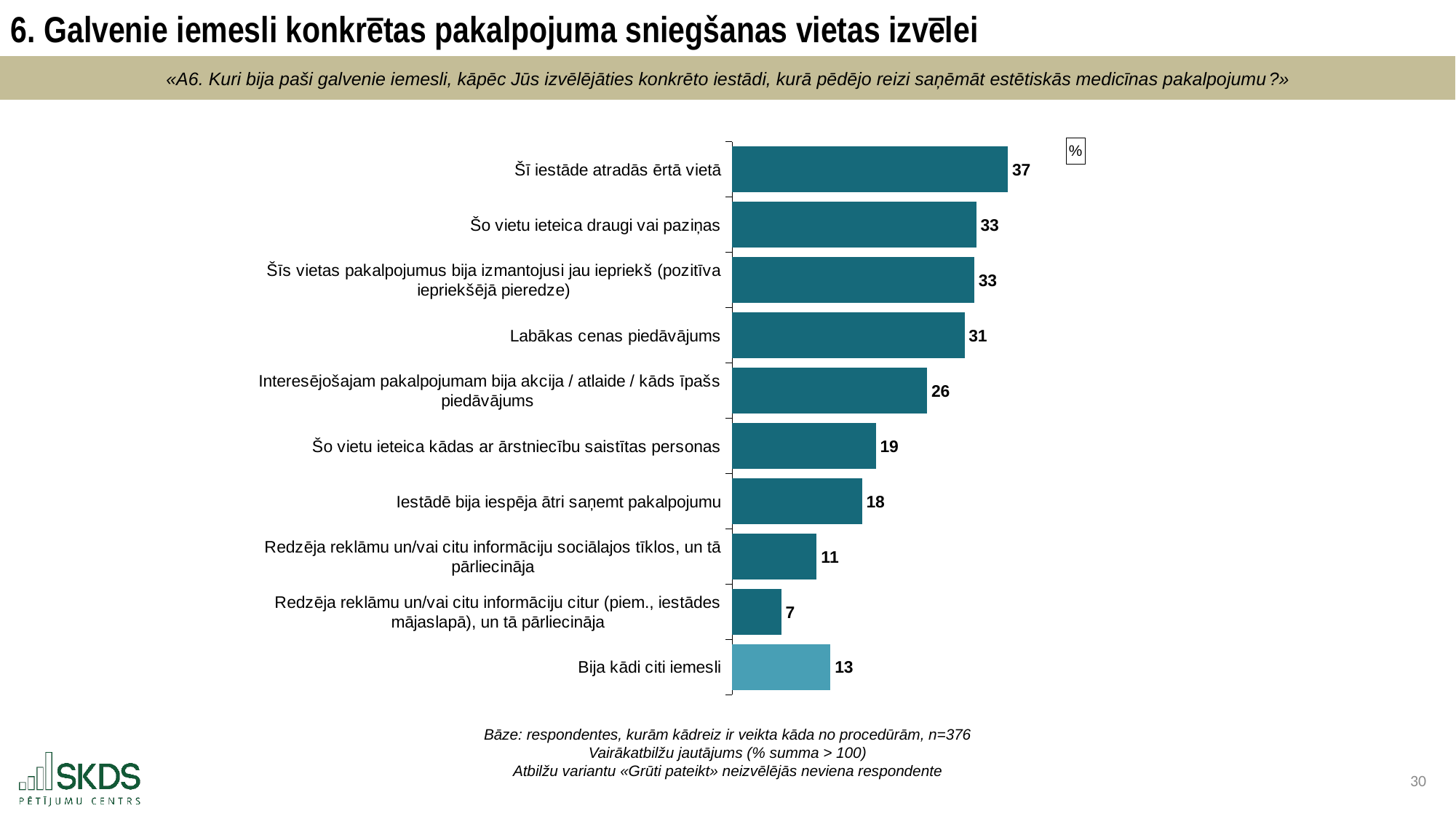
What is the value for "Labākas cenas piedāvājums"? 31 How many categories are shown in the chart? 10 What is the difference between the values for "Interesējošajam pakalpojumam bija akcija / atlaide / kāds īpašs piedāvājums" and "Šo vietu ieteica kādas ar ārstniecību saistītas personas"? 7 What kind of chart is shown on the slide? Bar chart What is the difference between the values for "Šī iestāde atradās ērtā vietā" and "Labākas cenas piedāvājums"? 6 Which category has the lowest value? Redzēja reklāmu un/vai citu informāciju citur (piem., iestādes mājaslapā), un tā pārliecināja What is the value for "Bija kādi citi iemesli"? 13 Which category has the highest value? Šī iestāde atradās ērtā vietā Which is larger: the value for "Redzēja reklāmu un/vai citu informāciju sociālajos tīklos, un tā pārliecināja" or the value for "Bija kādi citi iemesli"? Bija kādi citi iemesli What is the value for "Šī iestāde atradās ērtā vietā"? 37 Which bar is shown in a different (lighter) colour from the others? Bija kādi citi iemesli What is the value for "Iestādē bija iespēja ātri saņemt pakalpojumu"? 18